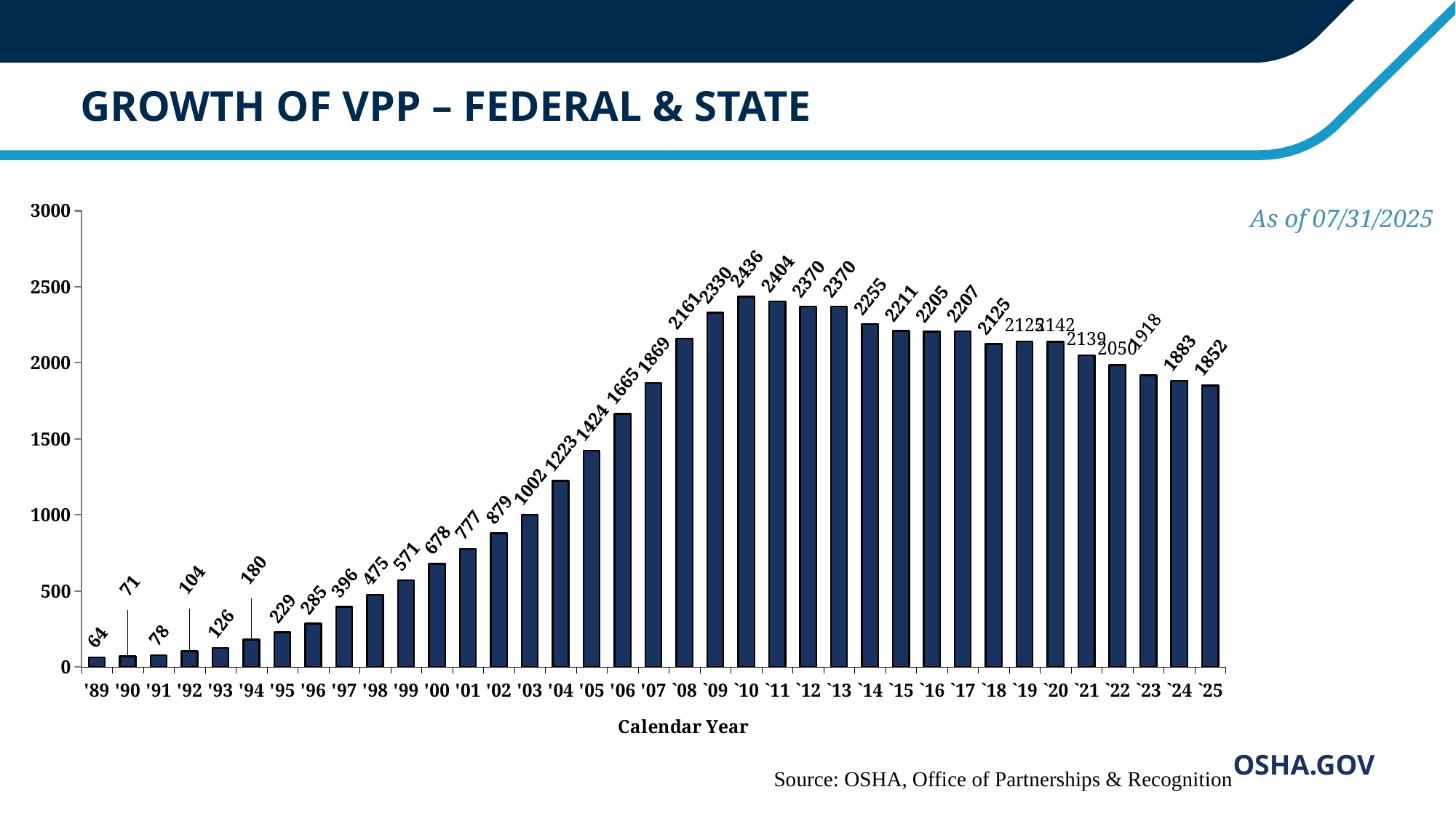
What is the difference between the values for '10 and '25? 584 What is the value for '00? 678 Which year has the lowest value? '89 Is the value for '19 greater or less than 2000? greater What is the value for '24? 1883 Which is larger, the value for '07 or the value for '08? '08 How many years are shown on the x axis? 37 What kind of chart is this? bar chart What is the value for '89? 64 Do the values rise or fall from '89 to '10? rise Which year has the highest value? '10 What is the value for '10? 2436